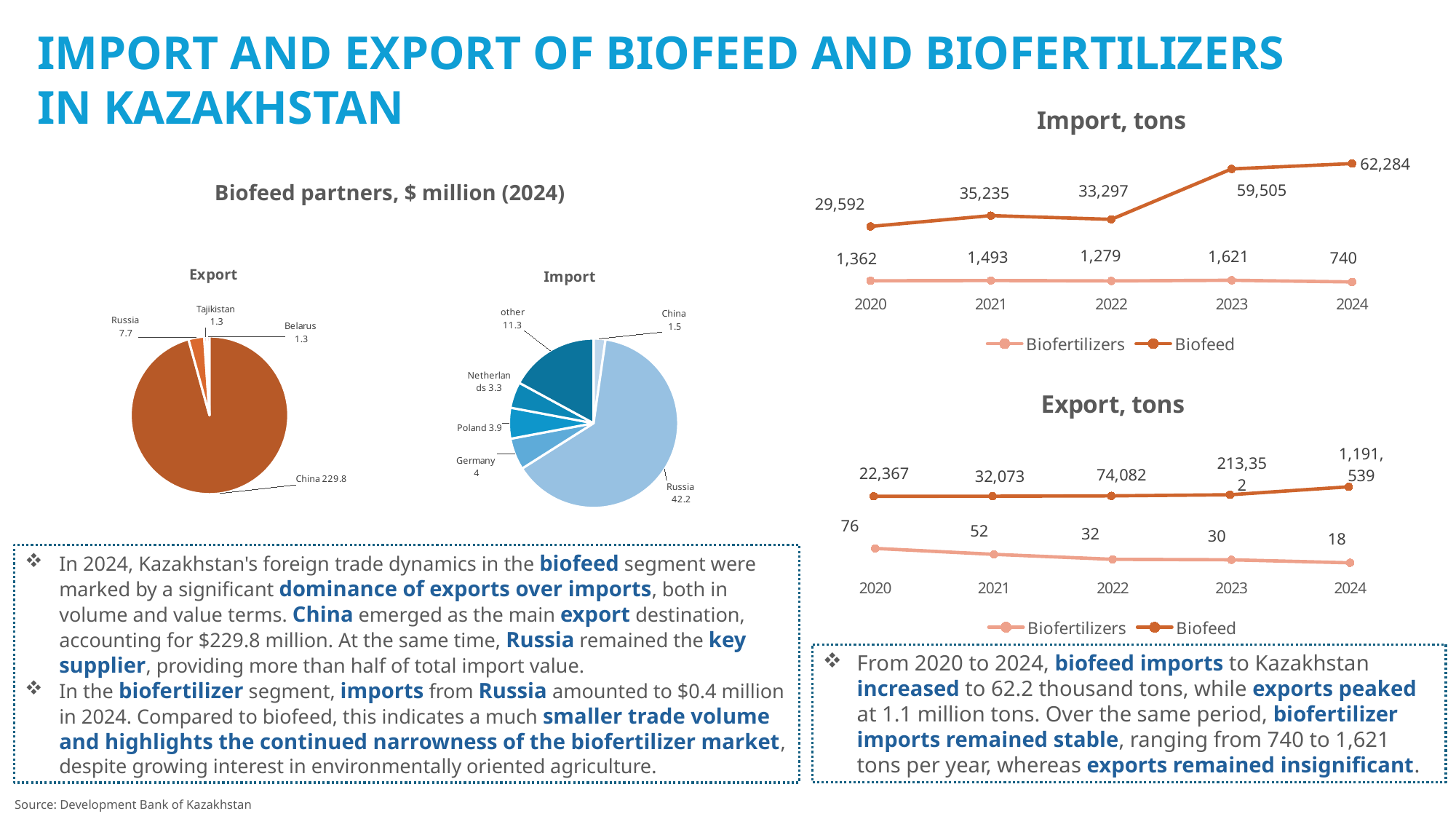
In the Export, tons chart, do the Biofertilizers values rise or fall from 2020 to 2024? fall In the Import, tons chart, by how much did Biofeed imports increase from 2023 to 2024? 2,779 In the Biofeed partners Import pie chart, which partner has the largest slice? Russia In the Export, tons chart, what is the Biofeed value for 2022? 74,082 In the Import, tons chart, what is the Biofeed value for 2024? 62,284 How many series does the legend of the Export, tons chart list? 2 What kind of chart is the Import, tons chart? line chart In the Biofeed partners Import pie chart, what is the value for Russia? 42.2 How many slices does the Biofeed partners Import pie chart have? 6 In the Biofeed partners Export pie chart, what is the value for China? 229.8 In the Import, tons chart, which year has the lowest Biofertilizers value? 2024 In the Import, tons chart, what is the Biofertilizers value for 2023? 1,621